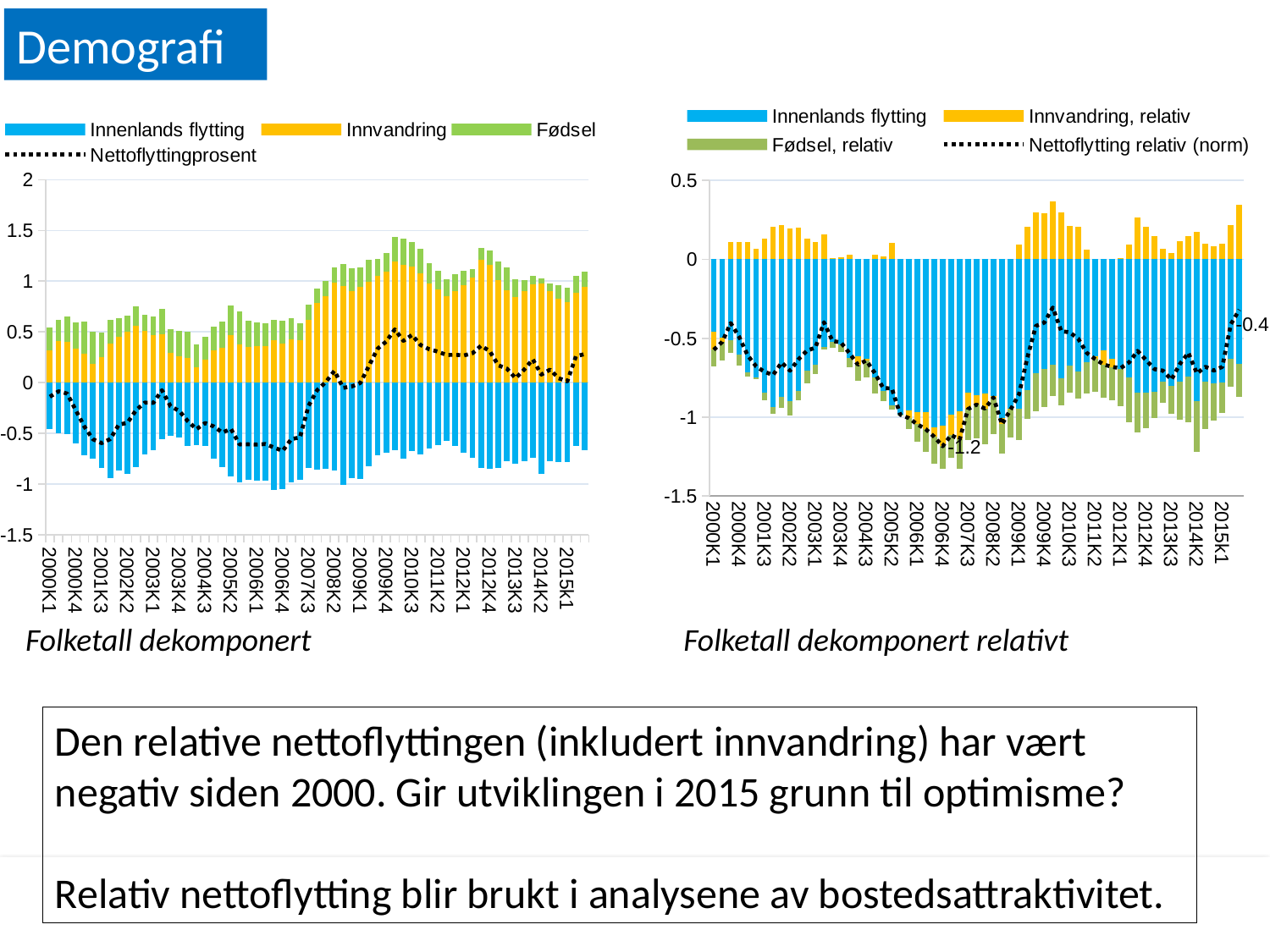
How many series does the legend of the right chart 'Folketall dekomponert relativt' list? 4 In the right chart 'Folketall dekomponert relativt', what is the difference between the labelled values -0.4 and -1.2 of the Nettoflytting relativ (norm) line? 0.8 In the right chart 'Folketall dekomponert relativt', what is the labelled value of the Nettoflytting relativ (norm) line at the end of the series in 2015? -0.4 In the right chart 'Folketall dekomponert relativt', is the Nettoflytting relativ (norm) value at 2009K4 greater or less than -0.5? greater In the right chart 'Folketall dekomponert relativt', which labelled value of the Nettoflytting relativ (norm) line is larger: the one around 2006K4 or the one in 2015? The one in 2015 (-0.4) In the left chart 'Folketall dekomponert', is the Innvandring value at 2009K4 greater or less than 1? greater How many series does the legend of the left chart 'Folketall dekomponert' list? 4 What kind of chart is the left chart titled 'Folketall dekomponert'? Bar chart (stacked bars with a dotted line) In the right chart 'Folketall dekomponert relativt', what is the labelled low value of the Nettoflytting relativ (norm) line around 2006K4–2007K1? -1.2 In the left chart 'Folketall dekomponert', which series is shown in yellow? Innvandring What is the title shown under the left chart? Folketall dekomponert In the left chart 'Folketall dekomponert', does the Nettoflyttingprosent line rise or fall between 2006K4 and 2009K4? rise